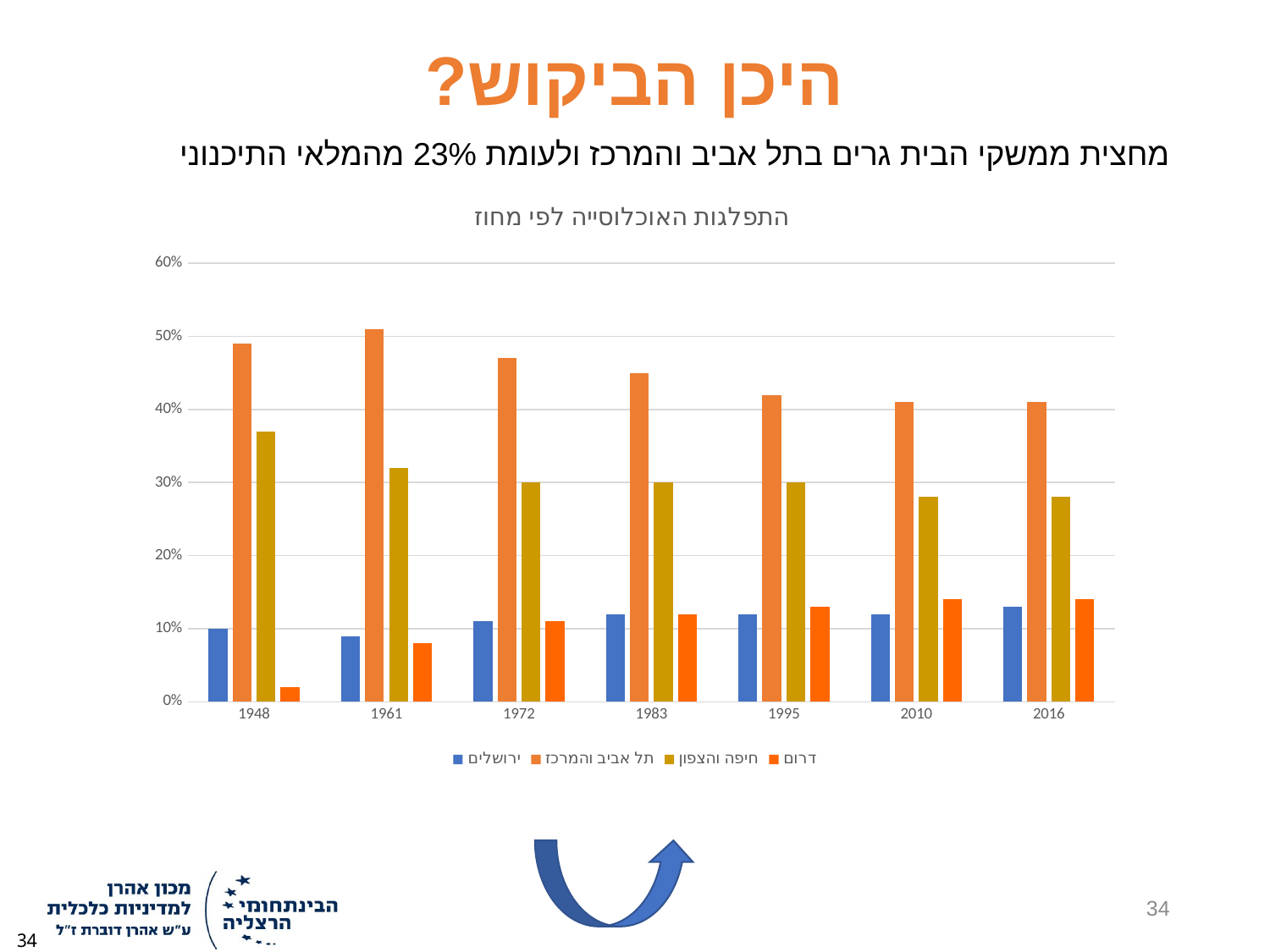
What kind of chart is shown on the slide? bar chart Which series is shown in blue in the chart? ירושלים Is the value for חיפה והצפון in 1948 greater or less than 30%? greater Is the value for דרום in 1948 greater or less than 10%? less Is the value for תל אביב והמרכז in 1983 greater or less than 50%? less How many years are shown on the x axis of the chart? 7 In which year does the תל אביב והמרכז series reach its highest value? 1961 What is the title of the chart? התפלגות האוכלוסייה לפי מחוז How many series does the chart's legend list? 4 Which is larger: the value for חיפה והצפון in 1948 or in 2016? 1948 In which year is the value for דרום lowest? 1948 Does the value for דרום rise or fall from 1948 to 2016? rise